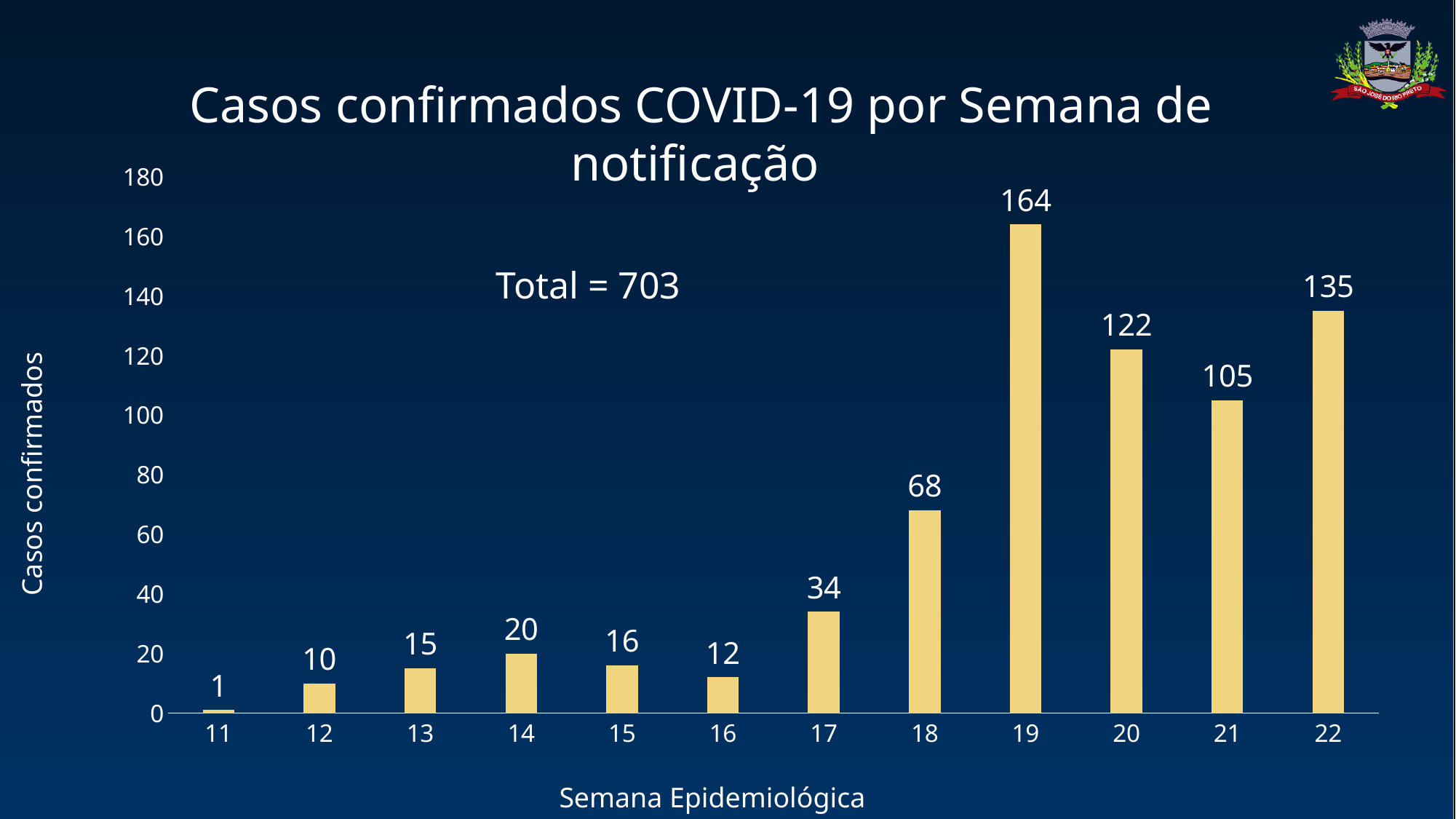
Which epidemiological week has the highest number of confirmed cases? 19 Which epidemiological week has the lowest number of confirmed cases? 11 Do the confirmed cases rise or fall from week 16 to week 19? Rise Which week has more confirmed cases, week 21 or week 22? 22 What kind of chart is shown on the slide? Bar chart What total is stated on the chart? Total = 703 How many epidemiological weeks are shown on the x axis? 12 What is the number of confirmed cases for epidemiological week 22? 135 What is the label of the y axis? Casos confirmados What is the number of confirmed cases for epidemiological week 19? 164 What is the number of confirmed cases for epidemiological week 14? 20 What is the difference in confirmed cases between week 19 and week 20? 42